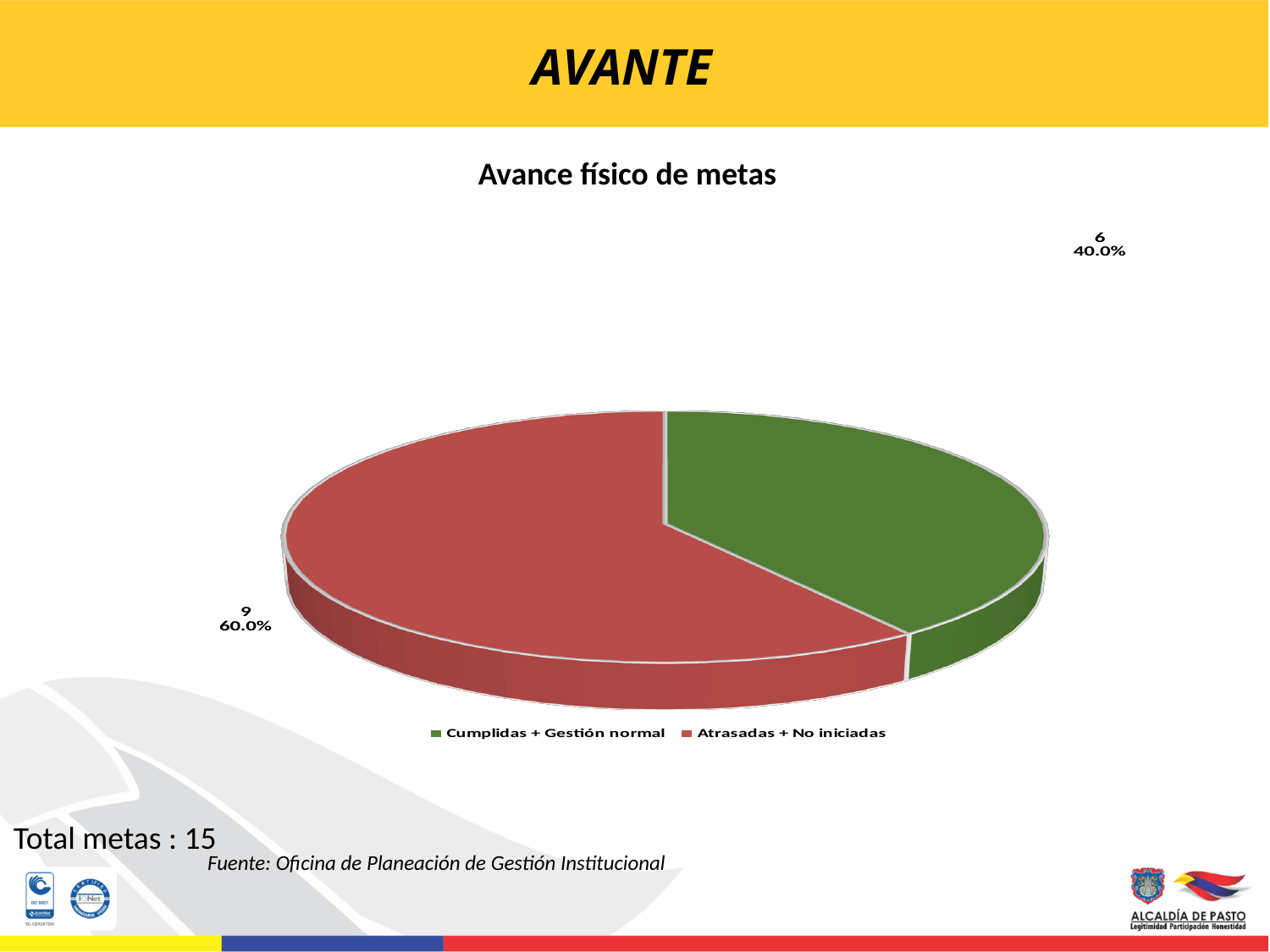
What share of the pie does Cumplidas + Gestión normal represent? 40.0% What is the difference between the values for Atrasadas + No iniciadas and Cumplidas + Gestión normal? 3 Which colour represents Cumplidas + Gestión normal? green What is the chart's title? Avance físico de metas Which category has the largest slice? Atrasadas + No iniciadas What share of the pie does Atrasadas + No iniciadas represent? 60.0% How many entries does the legend list? 2 What is the value for Atrasadas + No iniciadas? 9 What type of chart is shown on the slide? pie chart How many slices does the pie chart have? 2 Which category has the smallest slice? Cumplidas + Gestión normal What is the value for Cumplidas + Gestión normal? 6